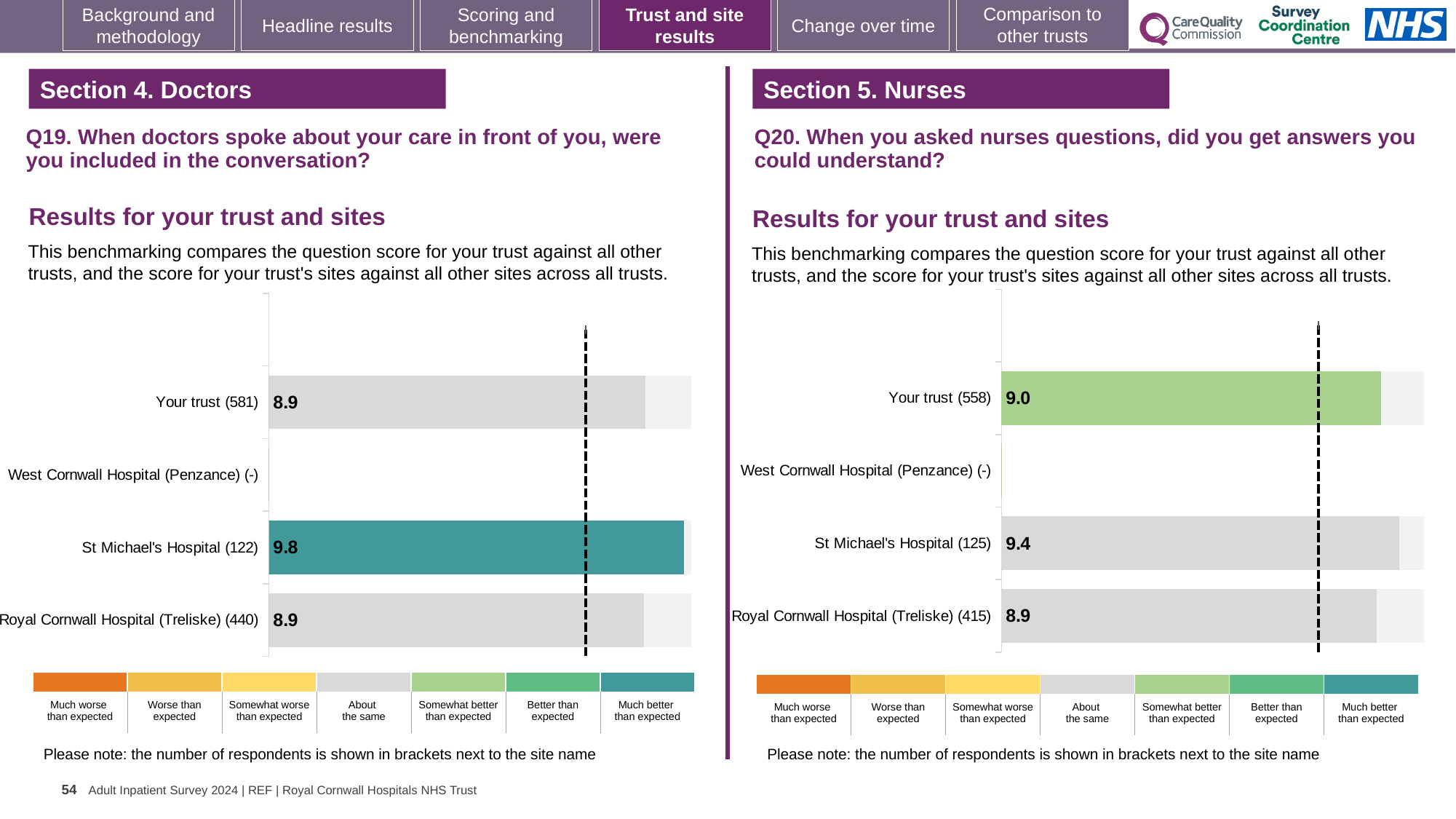
In the Q19 chart on the left, what is the score for St Michael's Hospital (122)? 9.8 What kind of chart is used for the Q20 results on the right? Bar chart In the Q20 chart on the right, which has the larger score, St Michael's Hospital (125) or Royal Cornwall Hospital (Treliske) (415)? St Michael's Hospital (125) In the Q19 chart on the left, which site has the highest score? St Michael's Hospital (122) In the Q20 chart on the right, what is the score for Your trust (558)? 9.0 In the Q19 chart on the left, what is the score for Your trust (581)? 8.9 In the Q19 chart on the left, what is the difference between the score for St Michael's Hospital (122) and the score for Royal Cornwall Hospital (Treliske) (440)? 0.9 In the Q20 chart on the right, what is the difference between the score for St Michael's Hospital (125) and the score for Your trust (558)? 0.4 In the Q19 chart on the left, which benchmark category does the colour of the St Michael's Hospital (122) bar correspond to? Much better than expected In the Q20 chart on the right, which site has the highest score? St Michael's Hospital (125) How many site rows (including Your trust) are listed in the Q19 chart on the left? 4 In the Q20 chart on the right, what is the score for Royal Cornwall Hospital (Treliske) (415)? 8.9